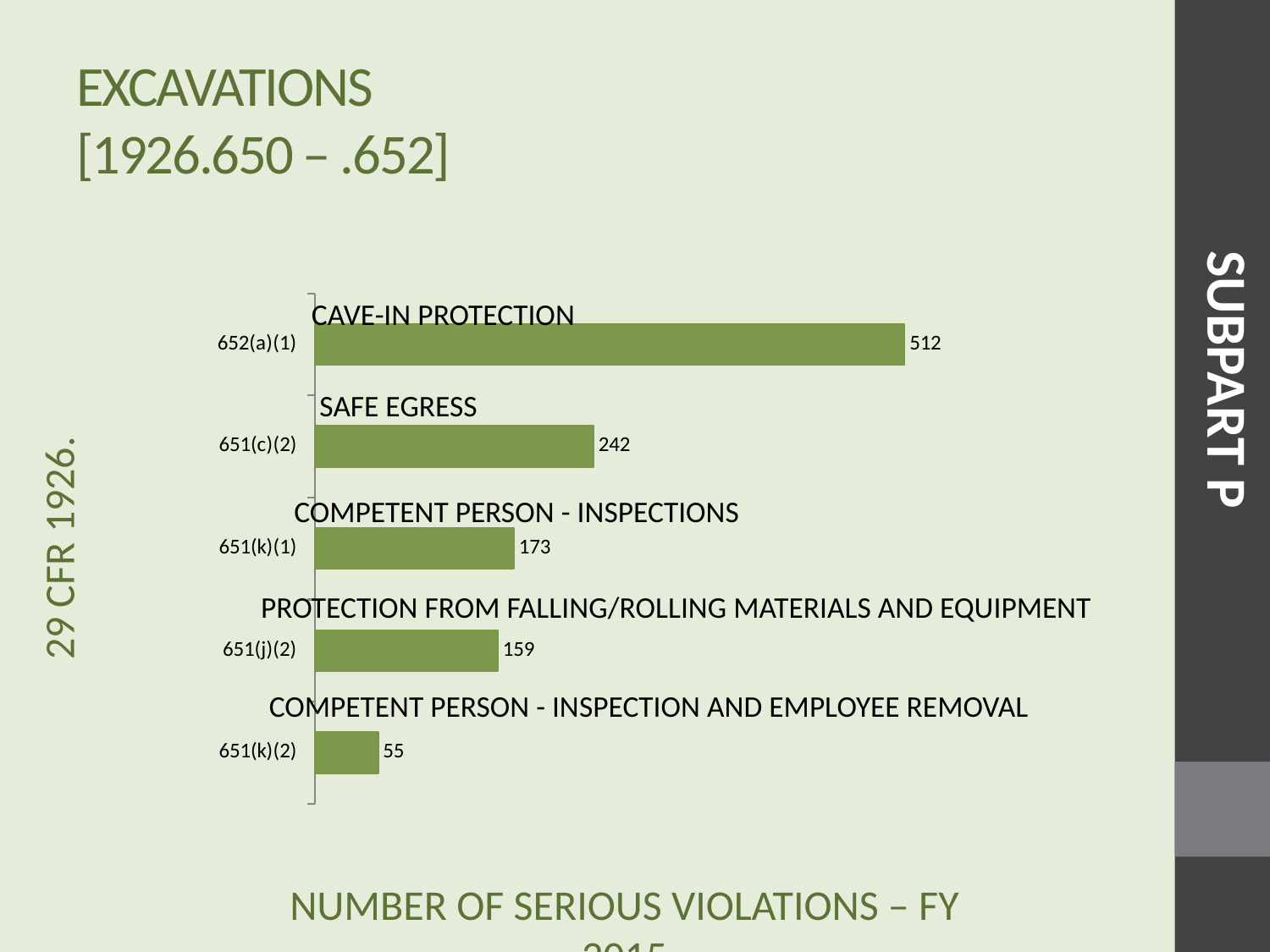
How many categories are shown in the chart? 5 What is the number of serious violations for 651(j)(2)? 159 Which category has the lowest number of serious violations? 651(k)(2) What is the number of serious violations for 651(c)(2)? 242 What is the difference between the values for 652(a)(1) and 651(c)(2)? 270 Which category has the highest number of serious violations? 652(a)(1) What description is shown above the bar for 651(c)(2)? SAFE EGRESS Which has more serious violations, 651(k)(1) or 651(j)(2)? 651(k)(1) What is the number of serious violations for 652(a)(1)? 512 What is the number of serious violations for 651(k)(1)? 173 What is the number of serious violations for 651(k)(2)? 55 What kind of chart is shown on the slide? Bar chart